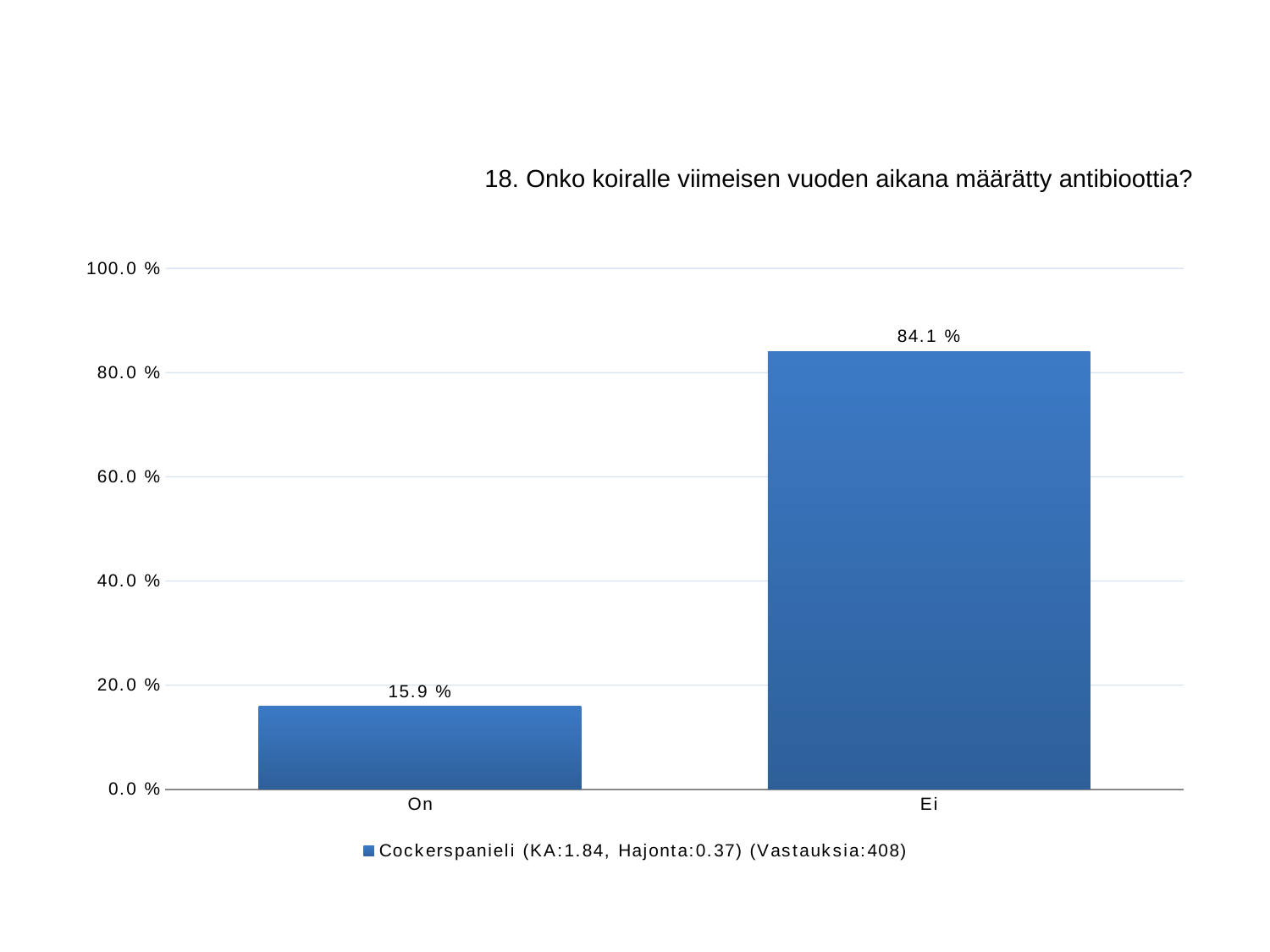
How many categories are shown on the x axis? 2 Is the value for "Ei" greater or less than 80.0 %? greater What is the value for "Ei"? 84.1 % What kind of chart is shown on the slide? Bar chart What is the difference between the values for "Ei" and "On"? 68.2 % What is the value for "On"? 15.9 % Which category has the lowest value? On Is the value for "On" greater or less than 20.0 %? less What is the title of the chart? 18. Onko koiralle viimeisen vuoden aikana määrätty antibioottia? Which is larger, the value for "On" or the value for "Ei"? Ei Which category has the highest value? Ei How many series does the legend list? 1